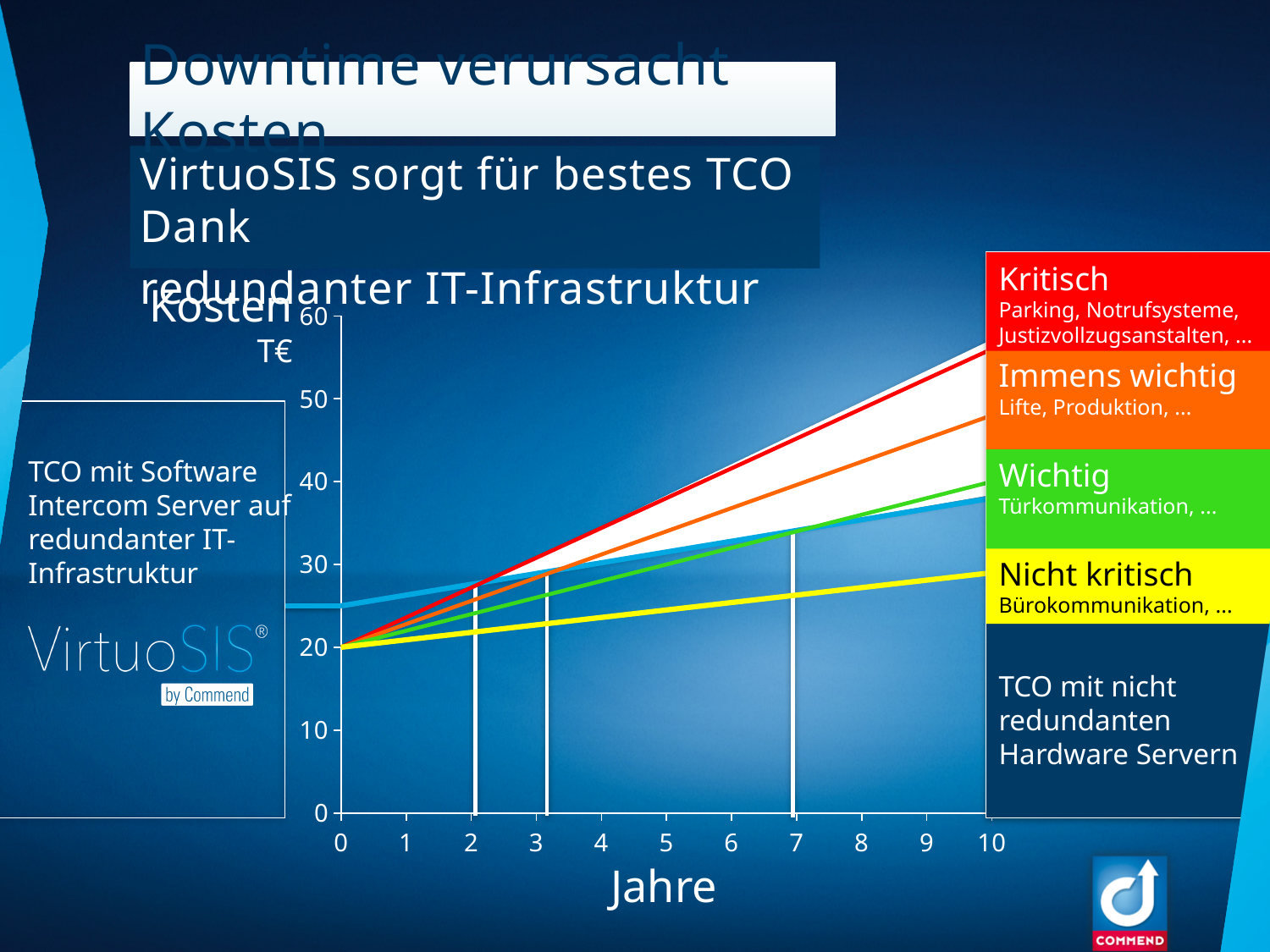
At year 0, what value does the yellow 'Nicht kritisch' line start at? 20 At year 0, what value does the red 'Kritisch' line start at? 20 How many year values are labelled on the x axis of the chart? 11 What is the highest value shown on the y axis of the chart? 60 What is the label of the y axis of the chart? Kosten T€ Which line reaches the highest cost at year 10? Kritisch (red) Which line has the lowest cost at year 10? Nicht kritisch (yellow) Do the cost lines rise or fall as the years increase? rise Is the value of the red 'Kritisch' line at year 10 greater or less than 50? greater What is the title of the x axis of the chart? Jahre What kind of chart is shown on the slide? line chart